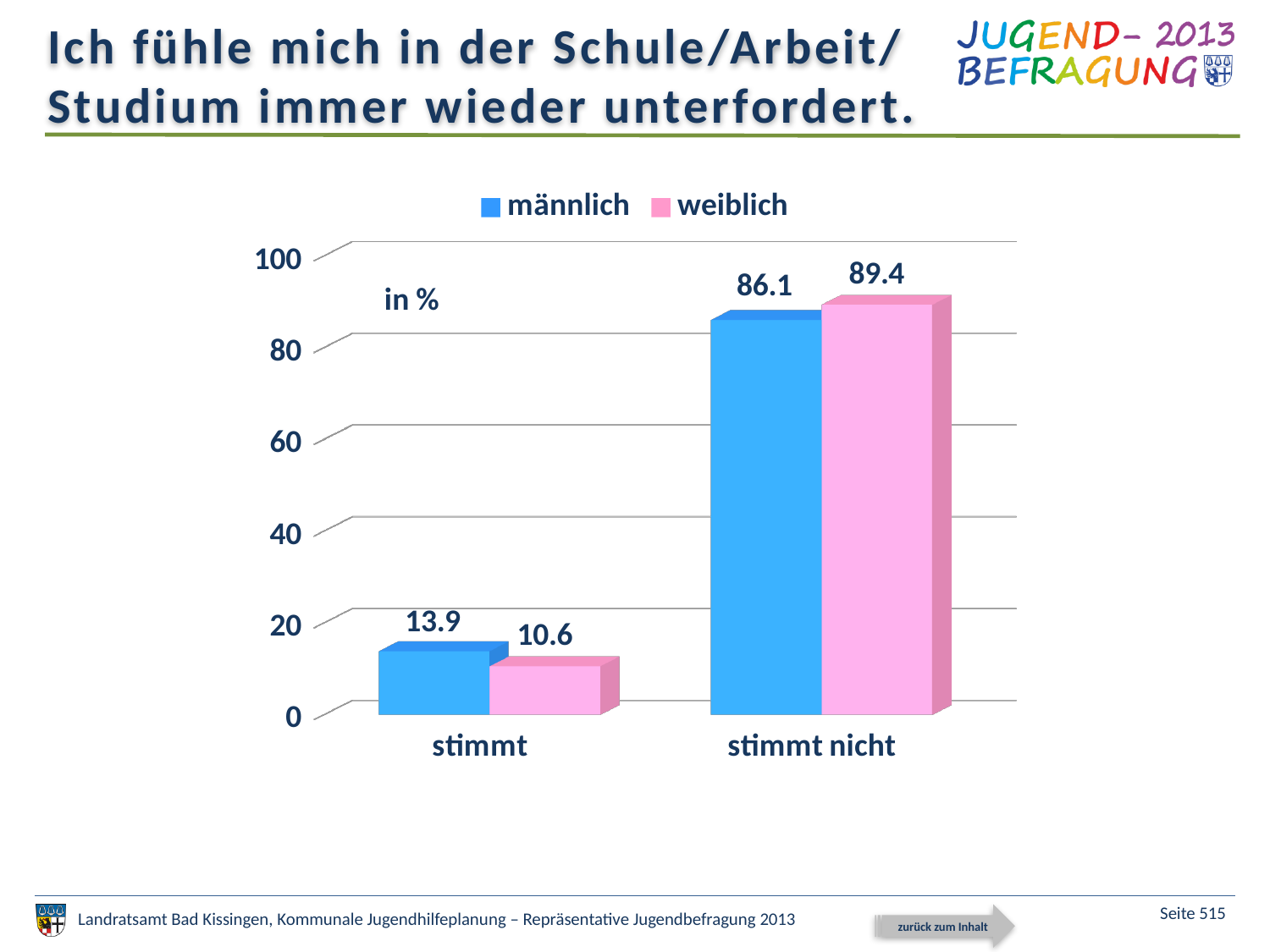
What kind of chart is shown on the slide? bar chart How many series does the legend list? 2 What is the difference between the weiblich and männlich values in the stimmt nicht category? 3.3 What is the value for weiblich in the stimmt nicht category? 89.4 What is the difference between the männlich and weiblich values in the stimmt category? 3.3 How many categories are shown on the x axis? 2 What is the value for männlich in the stimmt category? 13.9 Which bar has the lowest value on the chart? weiblich, stimmt In the stimmt category, which is larger: männlich or weiblich? männlich What is the value for weiblich in the stimmt category? 10.6 Which bar has the highest value on the chart? weiblich, stimmt nicht What is the value for männlich in the stimmt nicht category? 86.1